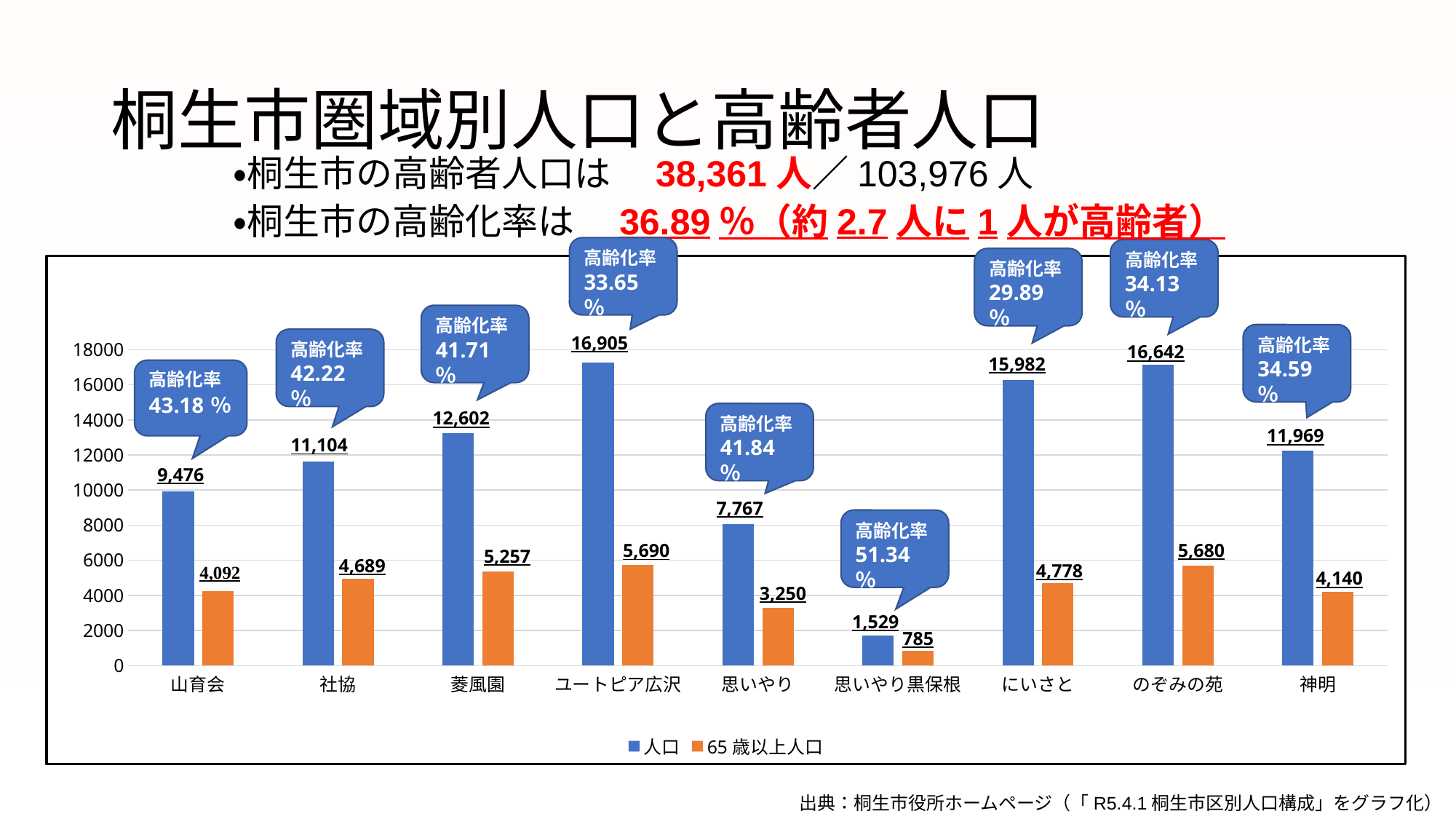
What is the 人口 value for ユートピア広沢? 16,905 How many series does the chart legend list? 2 What is the 65歳以上人口 value for 思いやり黒保根? 785 What is the 65歳以上人口 value for 菱風園? 5,257 What is the difference between the 人口 and 65歳以上人口 values for ユートピア広沢? 11,215 What kind of chart is shown on the slide? bar chart Is the 人口 value for 神明 greater or less than 10000? greater How many categories are shown on the x axis of the chart? 9 What is the difference between the 人口 values for 社協 and 山育会? 1,628 Which has a larger 人口 value, にいさと or 神明? にいさと Which category has the lowest 人口 value? 思いやり黒保根 Which category has the highest 人口 value? ユートピア広沢